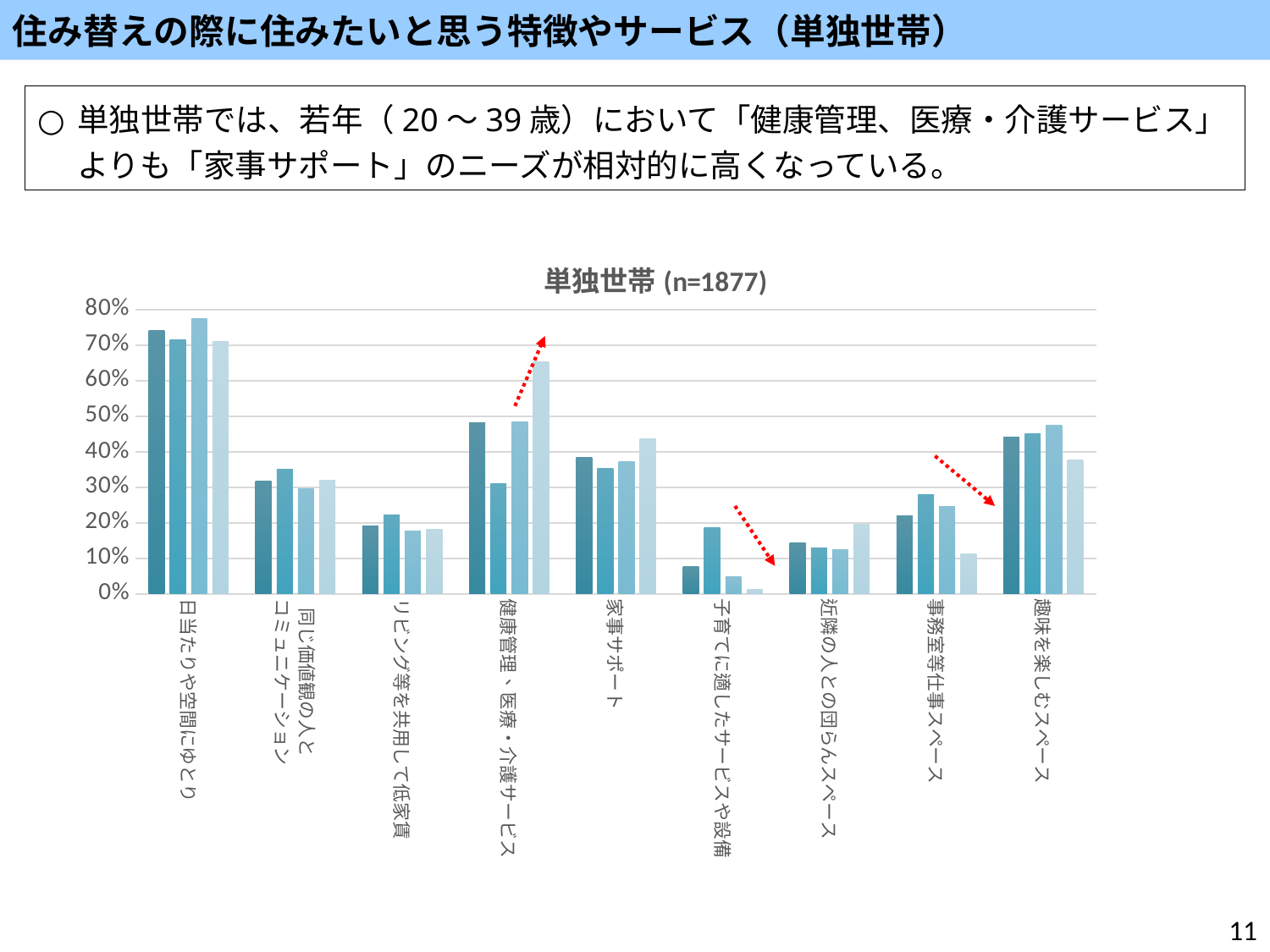
How many bars are plotted for each category? 4 Are the bars for リビング等を共用して低家賃 greater or less than 30%? less Are the bars for 日当たりや空間にゆとり greater or less than 60%? greater What is the title of the chart? 単独世帯 (n=1877) Which category has the lowest bars in the chart? 子育てに適したサービスや設備 What is the maximum value shown on the y axis? 80% How many categories are shown along the x axis of the chart? 9 Are the bars for 子育てに適したサービスや設備 greater or less than 20%? less What kind of chart is shown on the slide? bar chart Which category has higher bars, 家事サポート or 近隣の人との団らんスペース? 家事サポート Which category has the highest bars in the chart? 日当たりや空間にゆとり